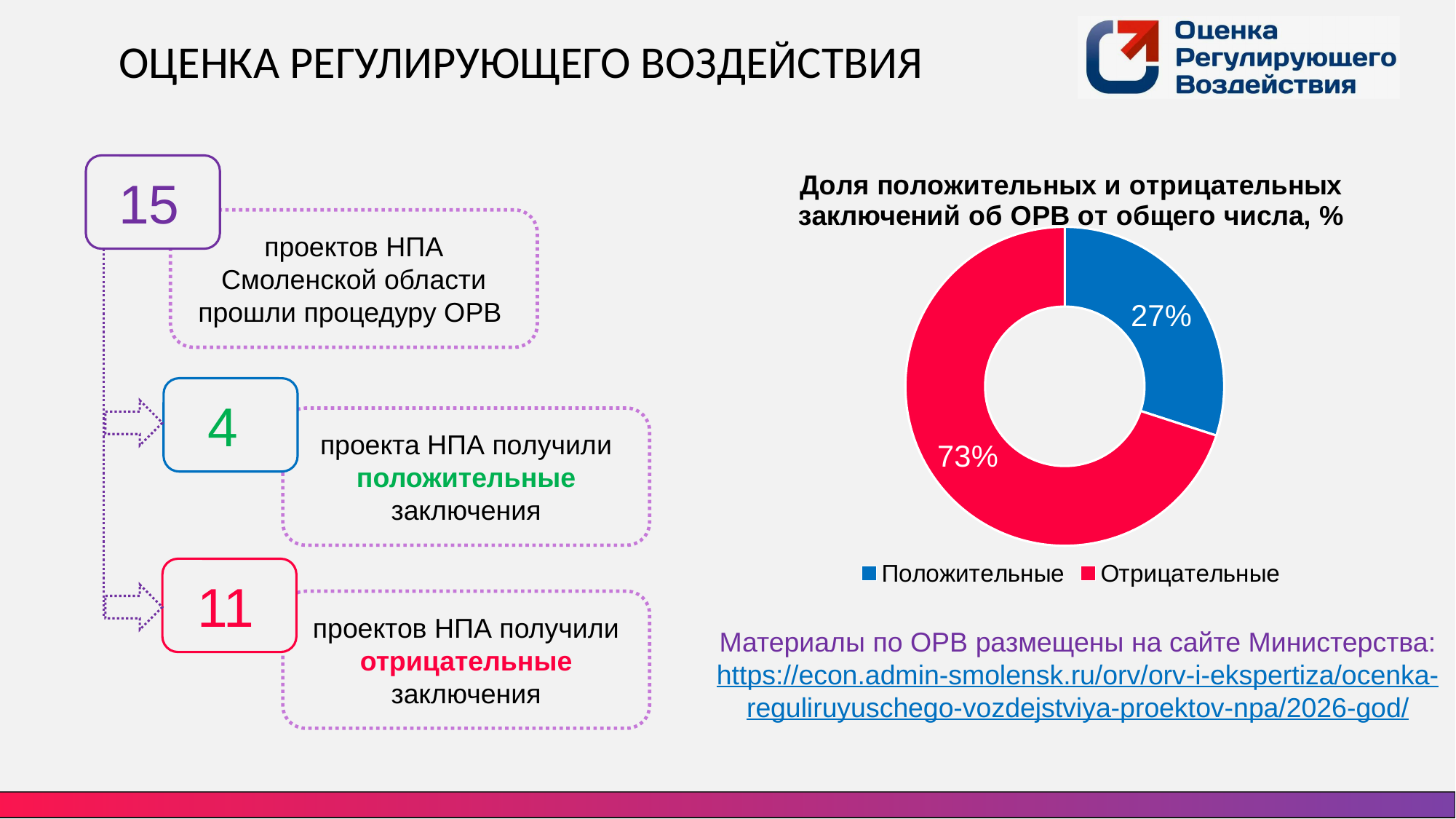
How many entries does the chart legend list? 2 What share of the chart does the Отрицательные slice represent? 73% Which category has the largest share in the chart? Отрицательные What share of the chart does the Положительные slice represent? 27% What colour is the Отрицательные slice in the chart? Red Which is larger, the share for Положительные or the share for Отрицательные? Отрицательные What is the title of the chart? Доля положительных и отрицательных заключений об ОРВ от общего числа, % What is the difference in percentage points between the Отрицательные and Положительные shares? 46 What kind of chart is shown on the slide? Pie chart (doughnut) How many categories does the chart show? 2 Which category has the smallest share in the chart? Положительные Is the share for Положительные greater or less than 50%? less